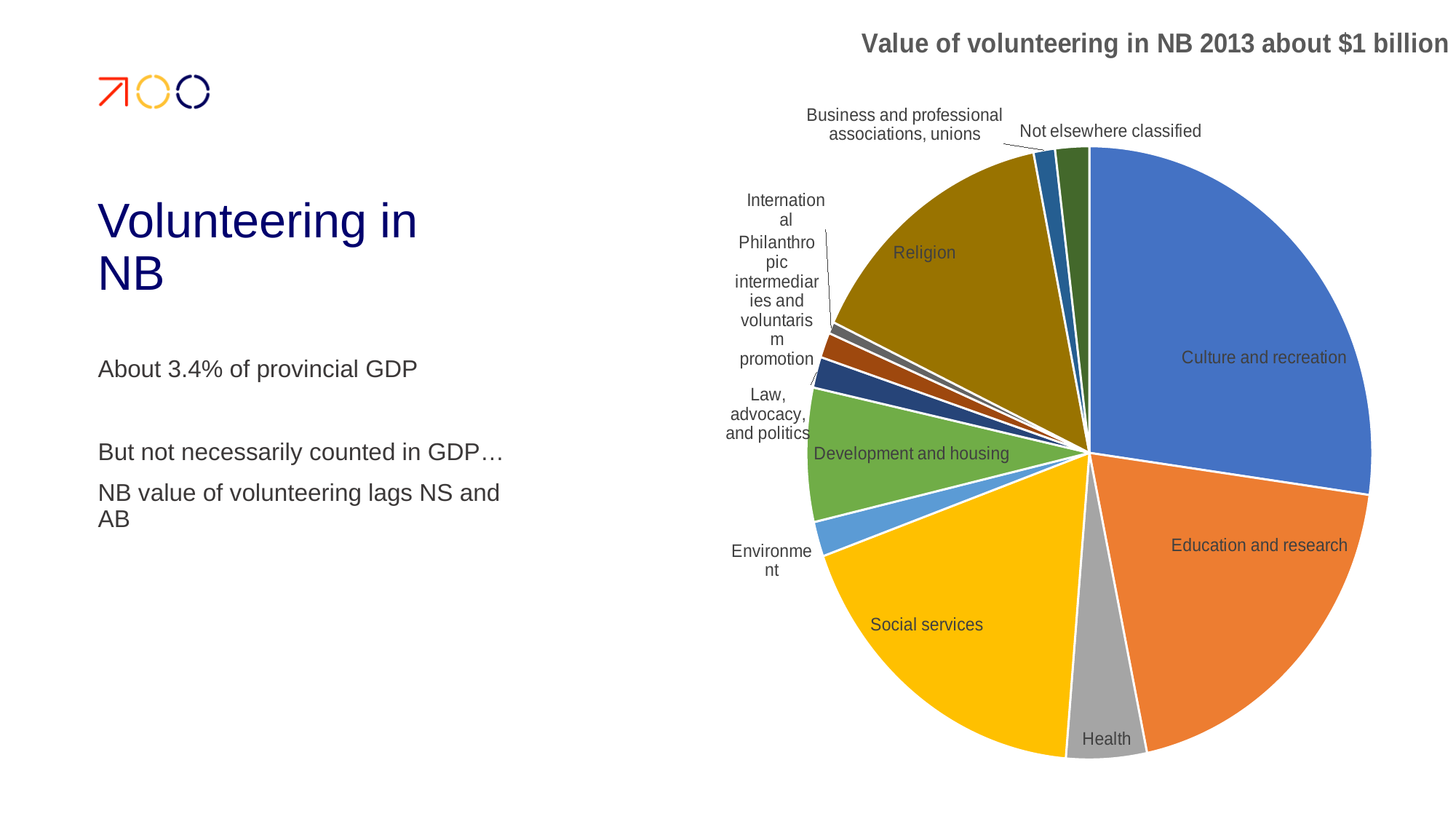
Which slice is larger, Religion or Development and housing? Religion What is the title of the chart? Value of volunteering in NB 2013 about $1 billion How many slices does the pie chart have? 12 Which slice is larger, Health or Not elsewhere classified? Health Which slice is larger, Culture and recreation or Education and research? Culture and recreation Which category has the largest slice of the pie? Culture and recreation What colour is the Social services slice? yellow What kind of chart is shown on the slide? pie chart